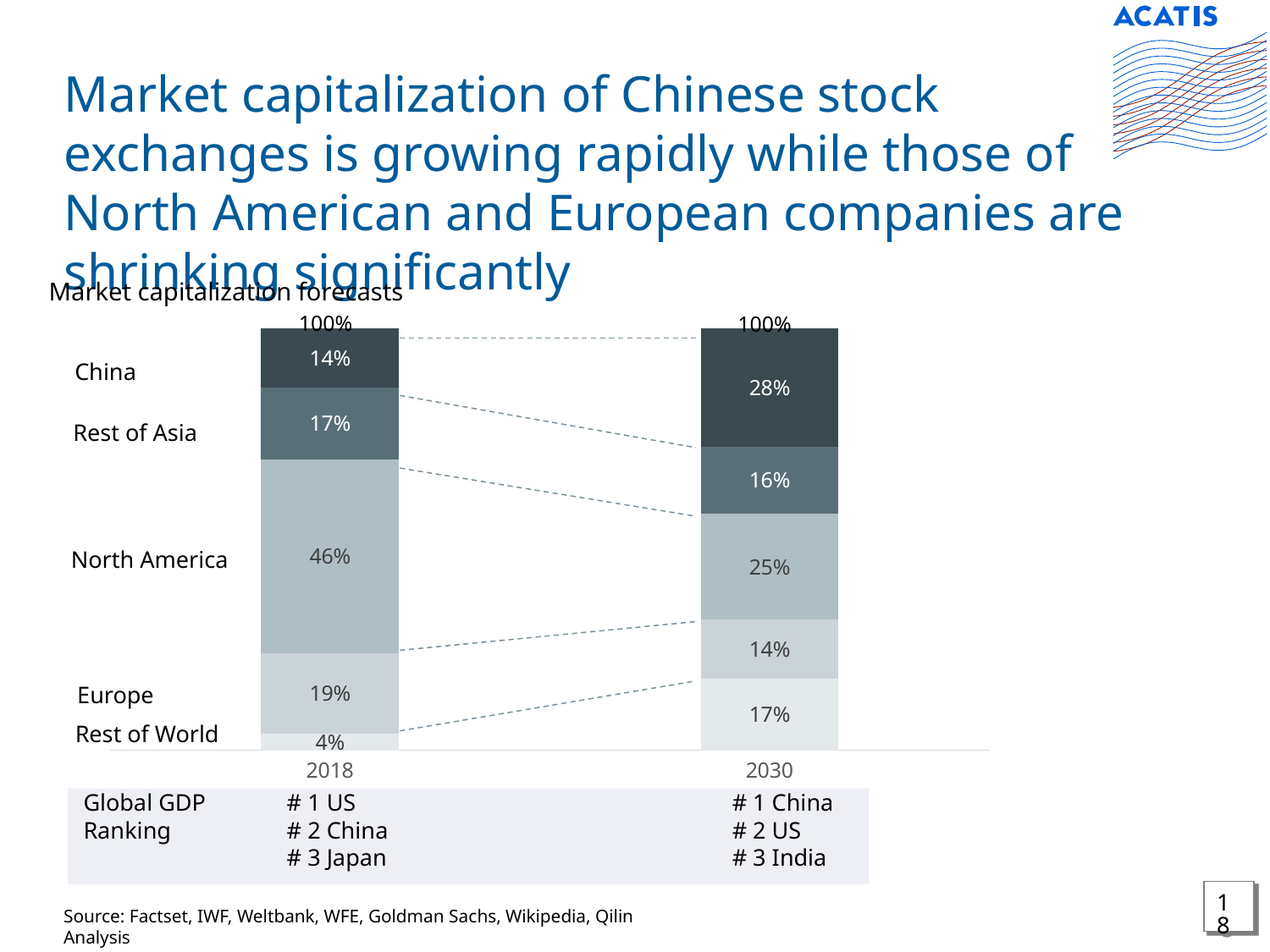
What is the North America share in the 2018 bar? 46% By how many percentage points does China's share change from 2018 to 2030? 14% What share of market capitalization does China hold in 2030? 28% What is the Rest of World share in the 2018 bar? 4% How many years (bars) are shown in the chart? 2 Which region has the largest share in the 2030 bar? China What is the title of the chart? Market capitalization forecasts Which region has the largest share in the 2018 bar? North America Which region has the smallest share in the 2018 bar? Rest of World Is North America's share larger in 2018 or in 2030? 2018 What kind of chart is shown on the slide? Stacked bar chart What share of market capitalization does China hold in 2018? 14%